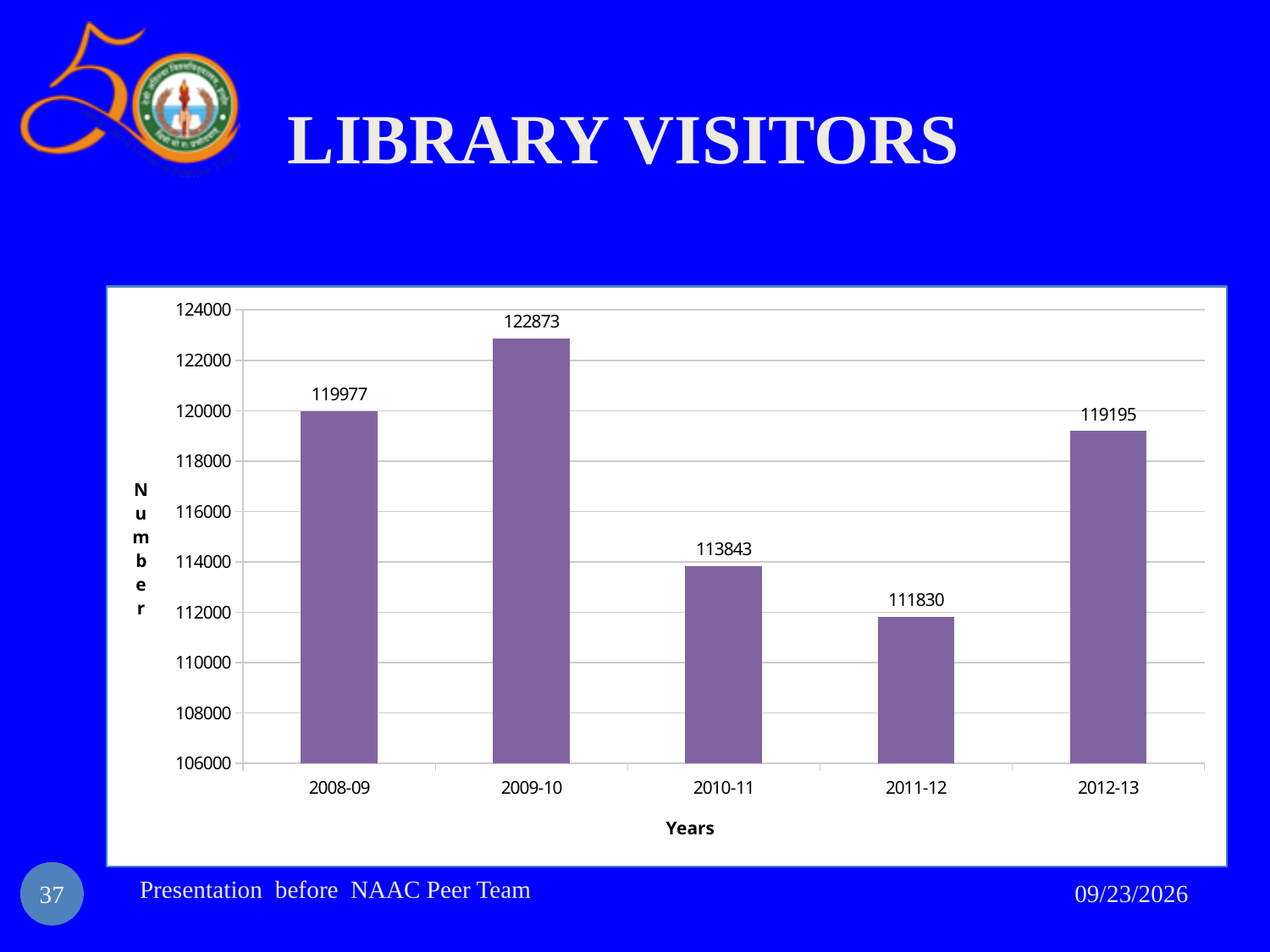
Which year has the lowest number of library visitors? 2011-12 Which year has the highest number of library visitors? 2009-10 What is the label of the x axis of the chart? Years What is the difference in library visitors between 2008-09 and 2012-13? 782 What is the number of library visitors in 2009-10? 122873 How many years are shown on the chart? 5 What is the number of library visitors in 2012-13? 119195 What is the difference in library visitors between 2009-10 and 2011-12? 11043 What is the number of library visitors in 2011-12? 111830 Is the number of library visitors in 2010-11 greater or less than 116000? less Which year had more library visitors, 2010-11 or 2012-13? 2012-13 What kind of chart is shown on the slide? bar chart